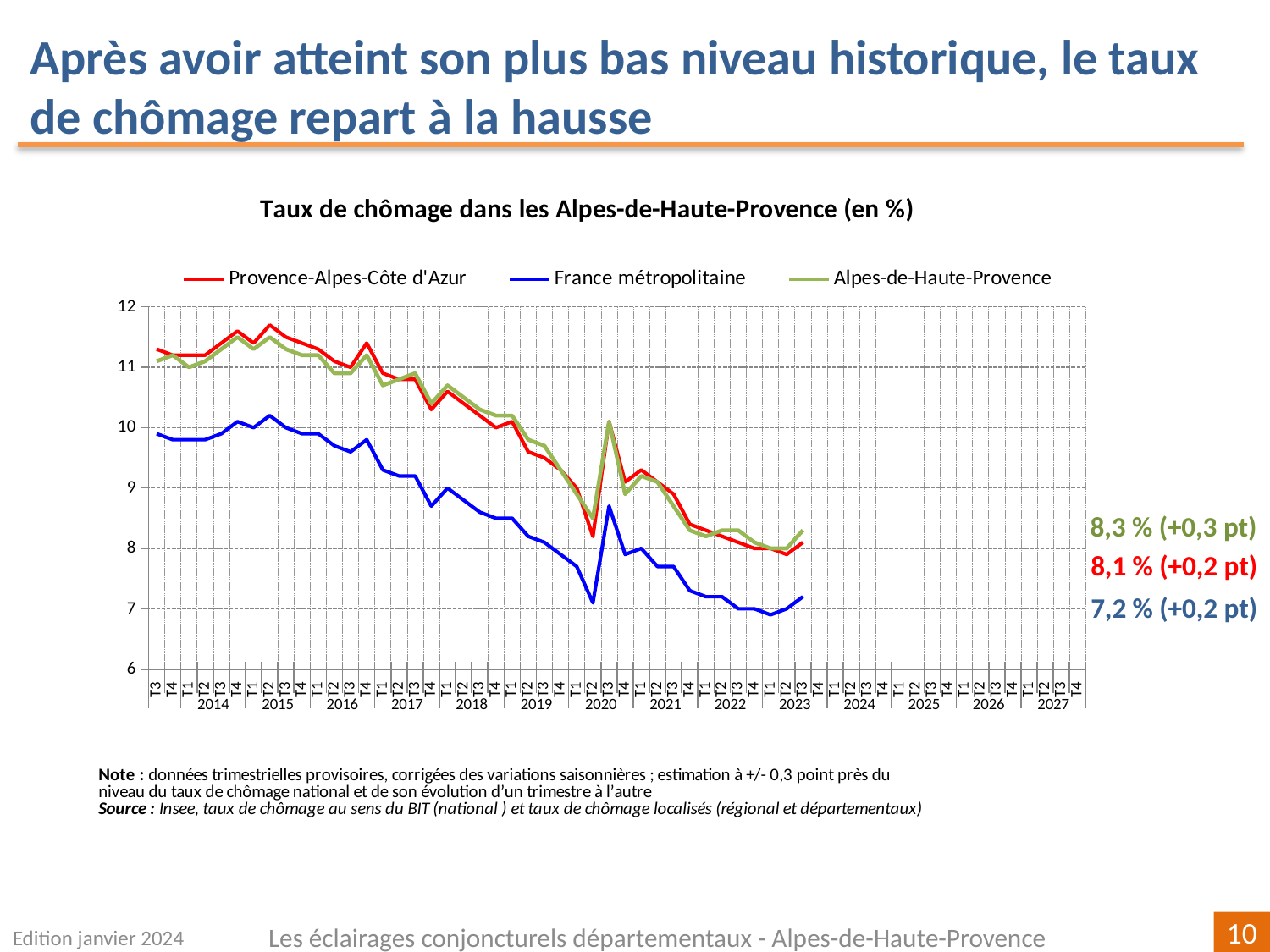
What quarterly change is shown next to the latest value for Alpes-de-Haute-Provence? +0,3 pt Is the value for France métropolitaine at the start of the series (T3 2013) greater or less than 9? greater How many series does the legend list? 3 What is the latest unemployment rate shown for Provence-Alpes-Côte d'Azur? 8,1 % Which series has the highest latest value? Alpes-de-Haute-Provence What is the title of the chart? Taux de chômage dans les Alpes-de-Haute-Provence (en %) Which series has the lowest latest value? France métropolitaine What is the latest unemployment rate shown for Alpes-de-Haute-Provence? 8,3 % What is the difference between the latest values for Alpes-de-Haute-Provence and France métropolitaine? 1,1 points Overall from 2014 to 2023, does the France métropolitaine line rise or fall? fall What kind of chart is shown on the slide? line chart What is the latest unemployment rate shown for France métropolitaine? 7,2 %